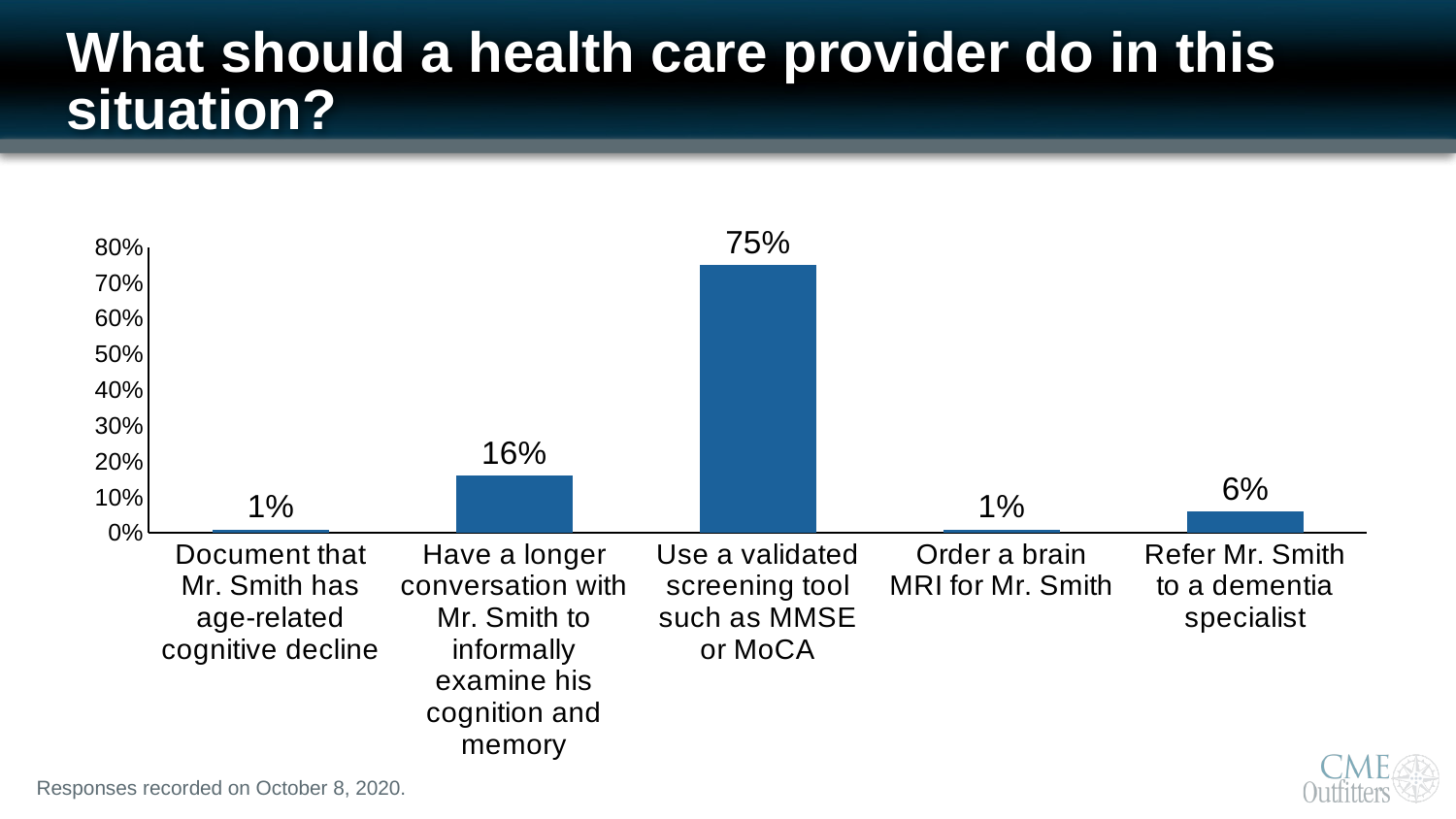
Which received a larger share of responses: "Refer Mr. Smith to a dementia specialist" or "Have a longer conversation with Mr. Smith to informally examine his cognition and memory"? Have a longer conversation with Mr. Smith to informally examine his cognition and memory What percentage of responses chose "Order a brain MRI for Mr. Smith"? 1% What percentage of responses chose "Use a validated screening tool such as MMSE or MoCA"? 75% What is the difference in percentage points between "Use a validated screening tool such as MMSE or MoCA" and "Have a longer conversation with Mr. Smith to informally examine his cognition and memory"? 59 percentage points Is the value for "Use a validated screening tool such as MMSE or MoCA" greater or less than 70%? greater What percentage of responses chose "Refer Mr. Smith to a dementia specialist"? 6% What type of chart is shown on the slide? Bar chart What percentage of responses chose "Have a longer conversation with Mr. Smith to informally examine his cognition and memory"? 16% What is the difference in percentage points between "Refer Mr. Smith to a dementia specialist" and "Order a brain MRI for Mr. Smith"? 5 percentage points How many response options are shown on the chart? 5 On what date were the responses recorded, according to the slide? October 8, 2020 Which response option received the highest percentage? Use a validated screening tool such as MMSE or MoCA